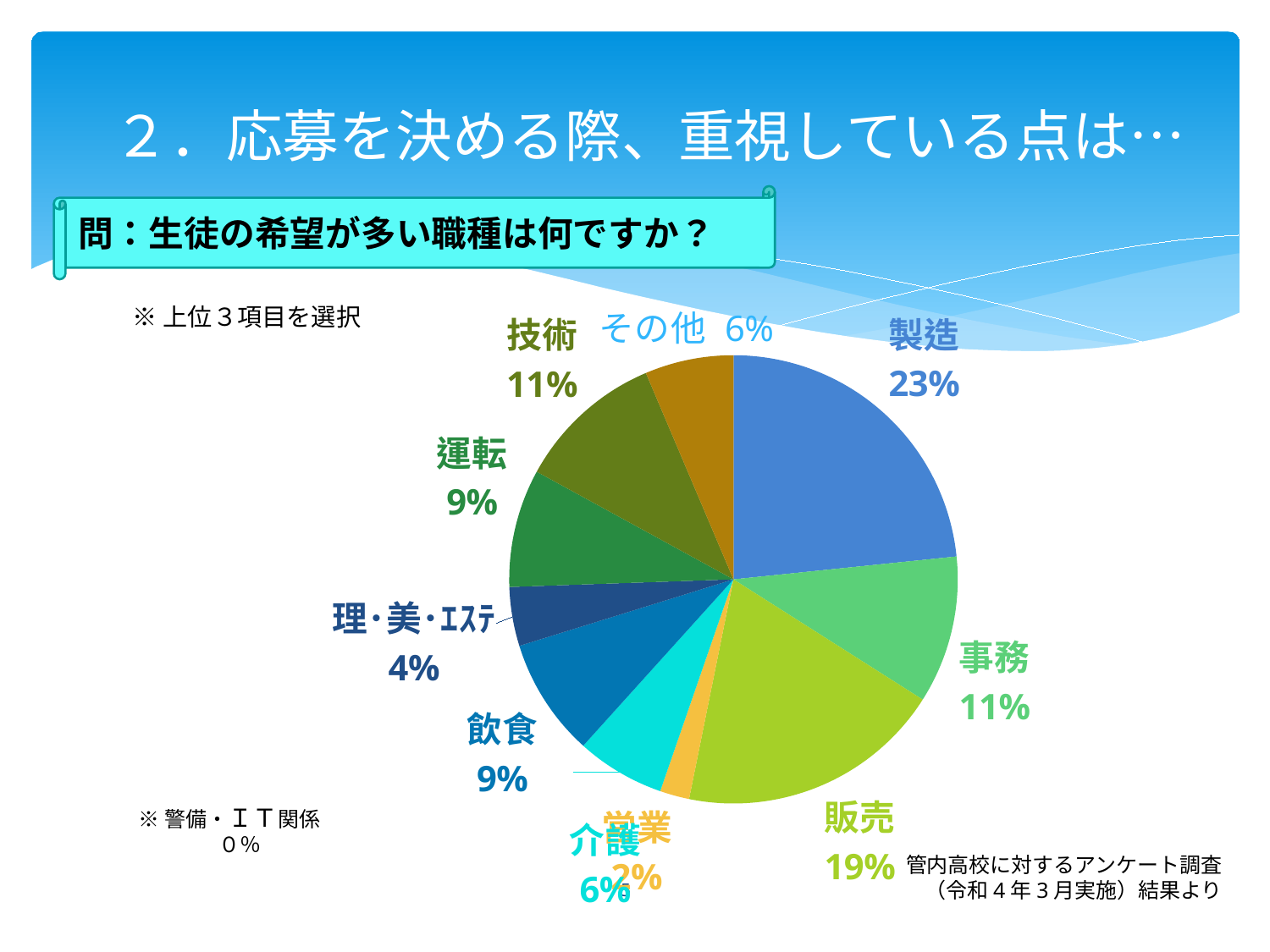
What is the difference in percentage points between 製造 and 販売? 4 What percentage of the pie is 介護? 6% What percentage of the pie is 理・美・エステ? 4% Which is larger, 運転 or 技術? 技術 What percentage is given for 警備・ＩＴ関係 in the note on the slide? 0％ What percentage of the pie is 製造? 23% Which category has the largest share of the pie? 製造 How many slices does the pie chart have? 10 What percentage of the pie is 営業? 2% What percentage of the pie is 販売? 19% Which category has the smallest share of the pie? 営業 What kind of chart is shown on the slide? pie chart